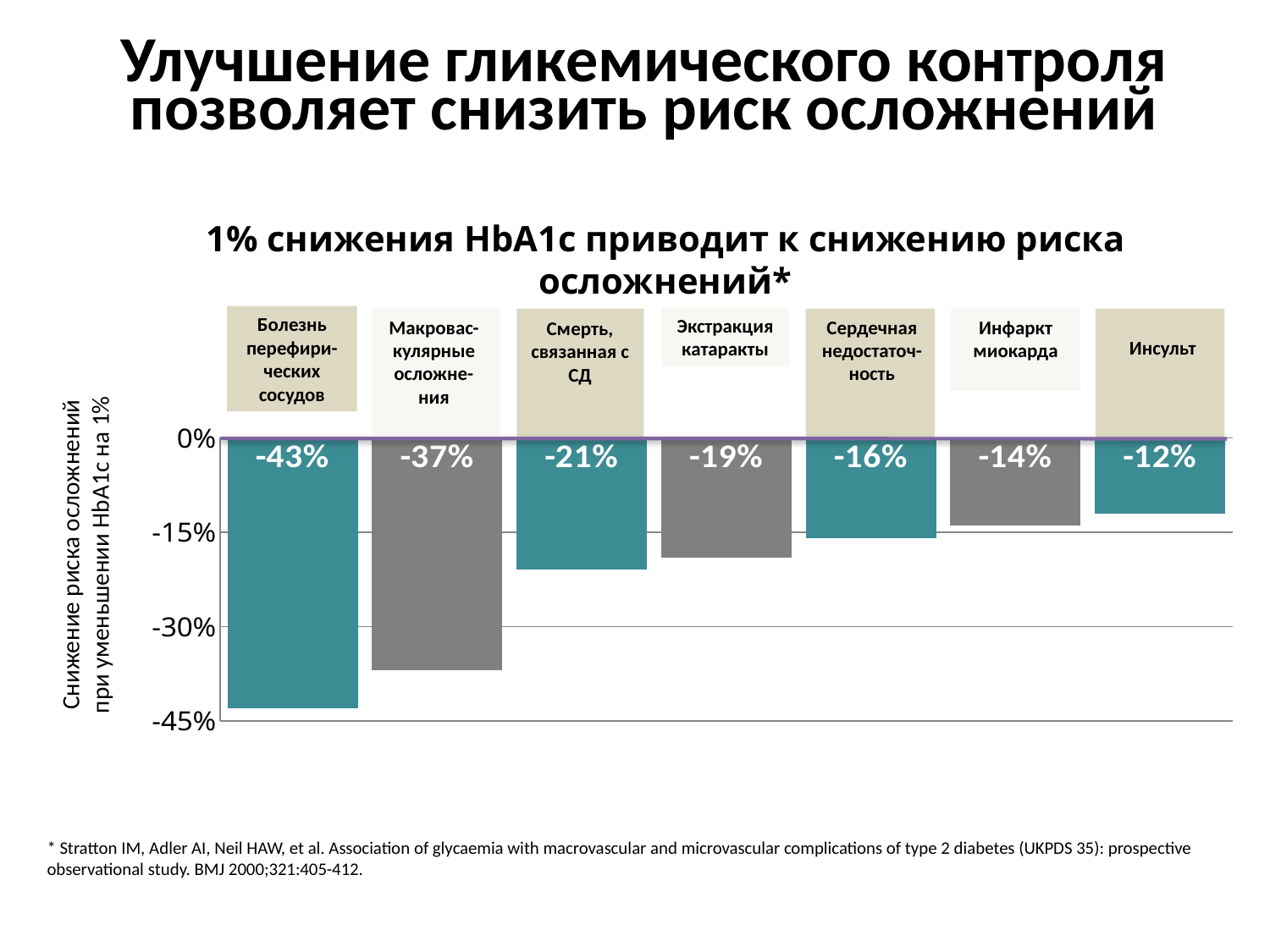
What is the value shown for Инсульт? -12% What type of chart is shown on the slide? Bar chart What is the value shown for Сердечная недостаточность? -16% What is the value shown for Экстракция катаракты? -19% What is the title of the chart? 1% снижения HbA1c приводит к снижению риска осложнений* What is the difference in percentage points between the values for Болезнь периферических сосудов and Макроваскулярные осложнения? 6 percentage points What is the value shown for Болезнь периферических сосудов? -43% Which category shows the smallest risk reduction (the value closest to 0%)? Инсульт How many categories are shown in the chart? 7 Which has a larger risk reduction: Смерть, связанная с СД or Инфаркт миокарда? Смерть, связанная с СД Is the value for Макроваскулярные осложнения greater or less than -30%? less Which category shows the largest risk reduction (the most negative value)? Болезнь периферических сосудов